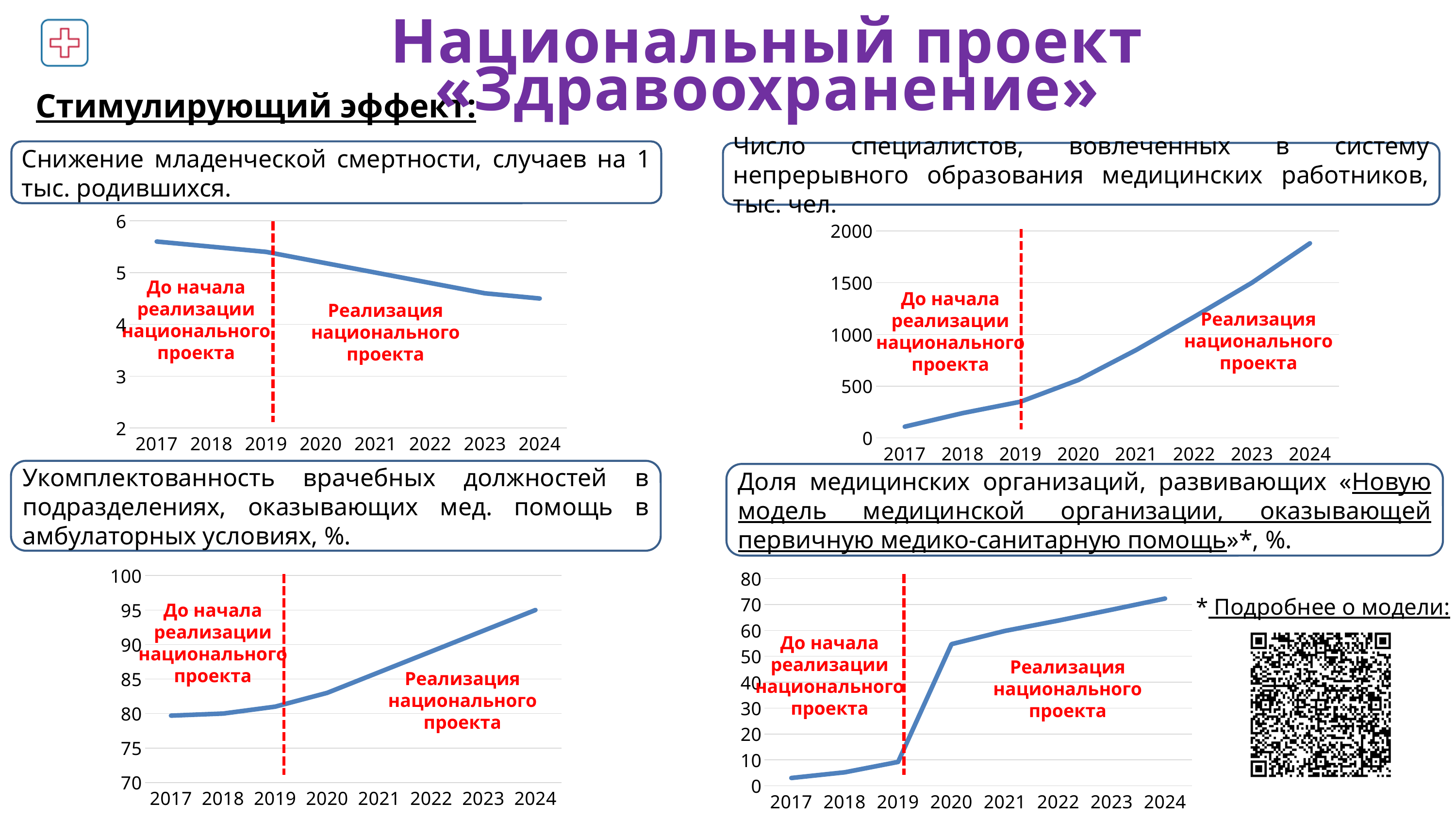
In the top-right chart (Число специалистов, вовлеченных в систему непрерывного образования), is the value for 2024 greater or less than 1500? greater How many years are shown on the x axis of the top-left chart (Снижение младенческой смертности)? 8 In the top-left chart (Снижение младенческой смертности), is the value for 2017 greater or less than 5? greater In the bottom-left chart (Укомплектованность врачебных должностей), which is larger, the value for 2019 or the value for 2023? 2023 In the top-left chart (Снижение младенческой смертности), which year has the lowest value? 2024 In the top-right chart (Число специалистов, вовлеченных в систему непрерывного образования), do the values rise or fall from 2017 to 2024? rise In the bottom-left chart (Укомплектованность врачебных должностей), is the value for 2017 greater or less than 85? less In the top-left chart (Снижение младенческой смертности), do the values rise or fall from 2017 to 2024? fall In the bottom-right chart (Доля медицинских организаций, развивающих «Новую модель»), what year does the red dashed vertical line mark? 2019 What kind of chart is the top-left chart (Снижение младенческой смертности)? line chart In the top-right chart (Число специалистов, вовлеченных в систему непрерывного образования), which year has the highest value? 2024